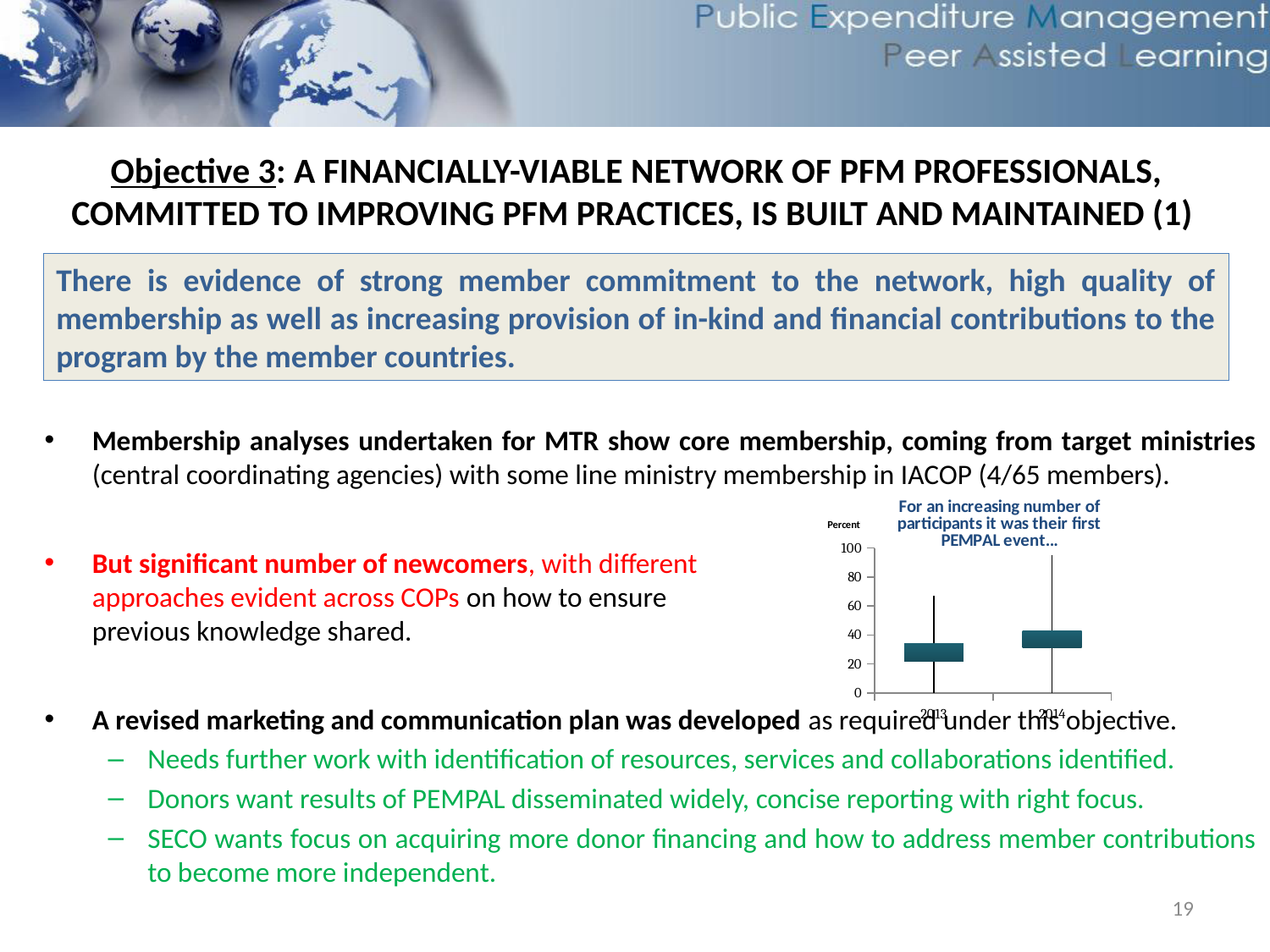
Does the box for 2014 sit higher or lower than the box for 2013? higher Is the upper whisker for 2013 greater or less than 80? less What is the label on the vertical axis of the chart? Percent Which year's upper whisker reaches higher on the chart, 2013 or 2014? 2014 What is the highest tick value shown on the vertical axis of the chart? 100 Which year's box sits higher on the chart, 2013 or 2014? 2014 Is the bottom of the box for 2014 greater or less than 20? greater Which years are shown on the x axis of the chart? 2013 and 2014 Is the top of the box for 2013 greater or less than 40? less What is the title of the chart on the slide? For an increasing number of participants it was their first PEMPAL event… How many categories are shown on the x axis of the chart? 2